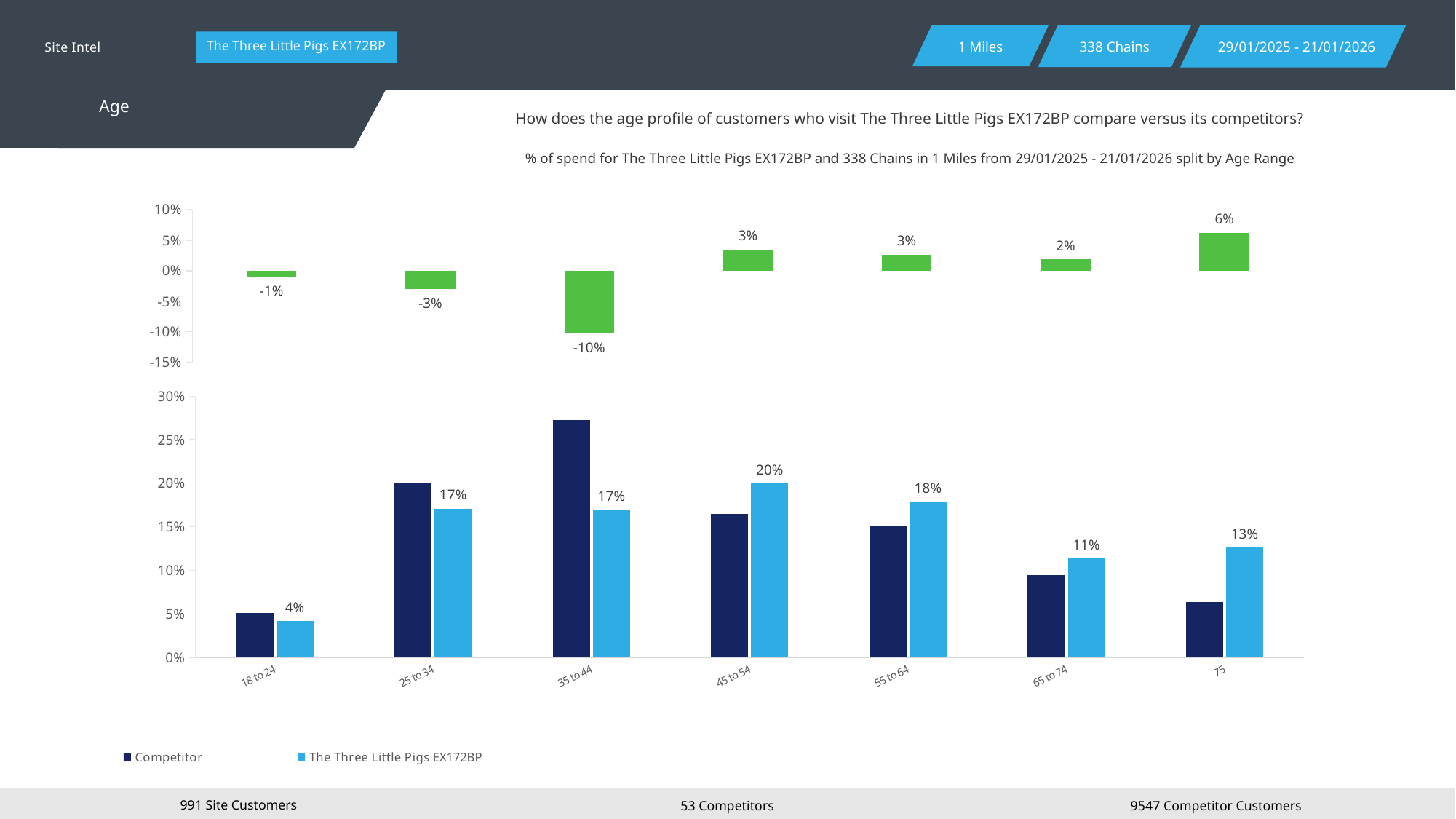
In the bottom chart, what is the value for The Three Little Pigs EX172BP in the 45 to 54 age range? 20% In the bottom chart, what is the difference between The Three Little Pigs EX172BP values for 45 to 54 and 65 to 74? 9% In the bottom chart, is the Competitor value for 35 to 44 greater or less than 25%? greater How many series does the legend of the bottom chart list? 2 In the top chart, what is the value for the 35 to 44 age range? -10% In the top chart, which age range has the lowest value? 35 to 44 In the top chart, which age range has the highest value? 75 In the bottom chart, which age range has the lowest value for The Three Little Pigs EX172BP? 18 to 24 What kind of chart is the bottom chart? bar chart How many age range categories are shown on the x axis of the bottom chart? 7 In the bottom chart, which age range has the highest value for The Three Little Pigs EX172BP? 45 to 54 In the bottom chart, for the 35 to 44 age range, which series has the larger value: Competitor or The Three Little Pigs EX172BP? Competitor